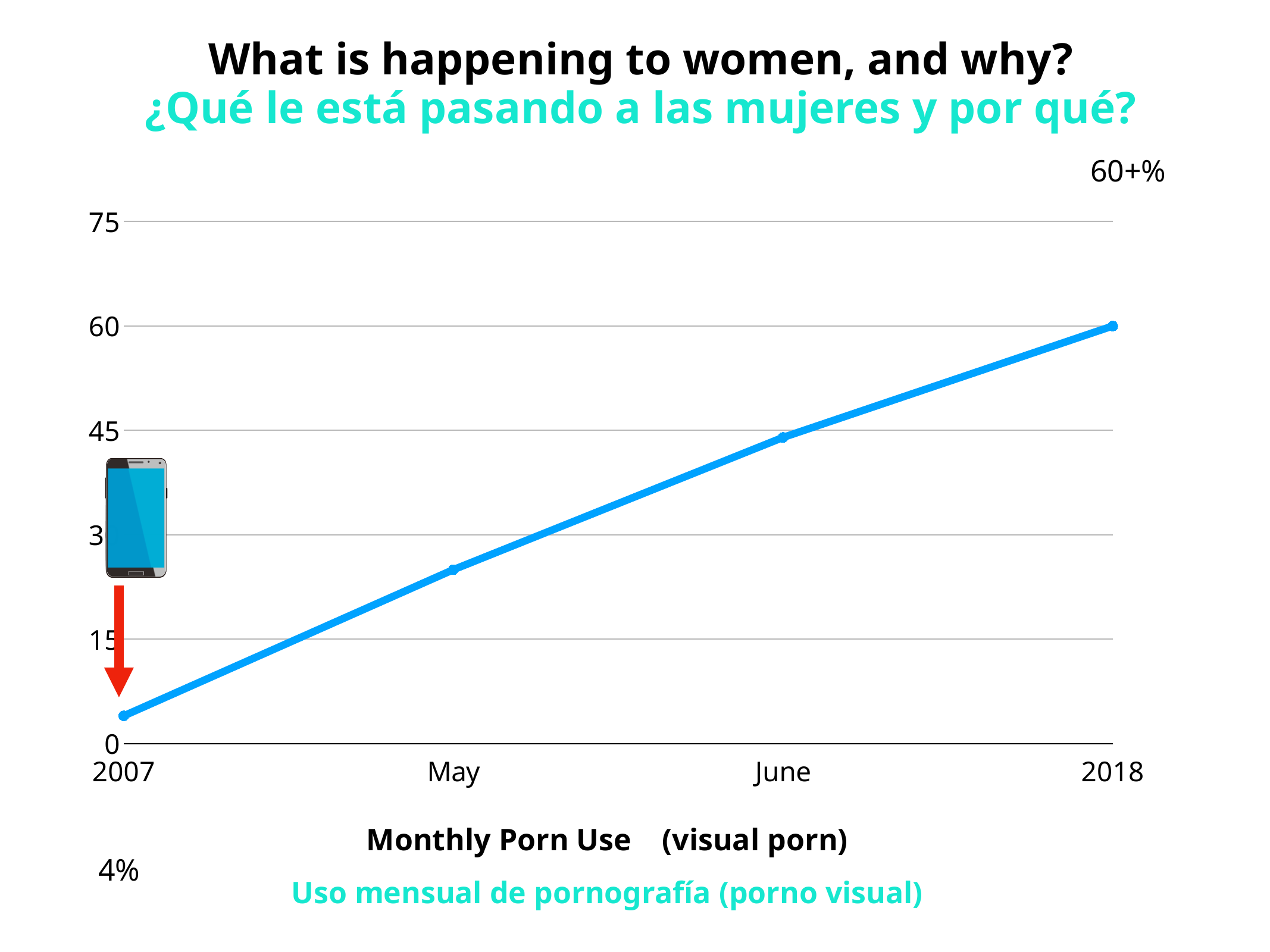
Which has the larger value, May or June? June What kind of chart is shown on the slide? line chart What value does the line reach at 2018? 60 Is the value for May greater or less than 15? greater Which x-axis category has the highest value? 2018 Which x-axis category has the lowest value? 2007 Is the value for June greater or less than 30? greater Do the values rise or fall from 2007 to 2018? rise Is the value for May greater or less than 30? less What percentage is annotated for the 2007 starting point? 4% What is the English title of the chart? Monthly Porn Use (visual porn) How many data points are plotted on the line? 4